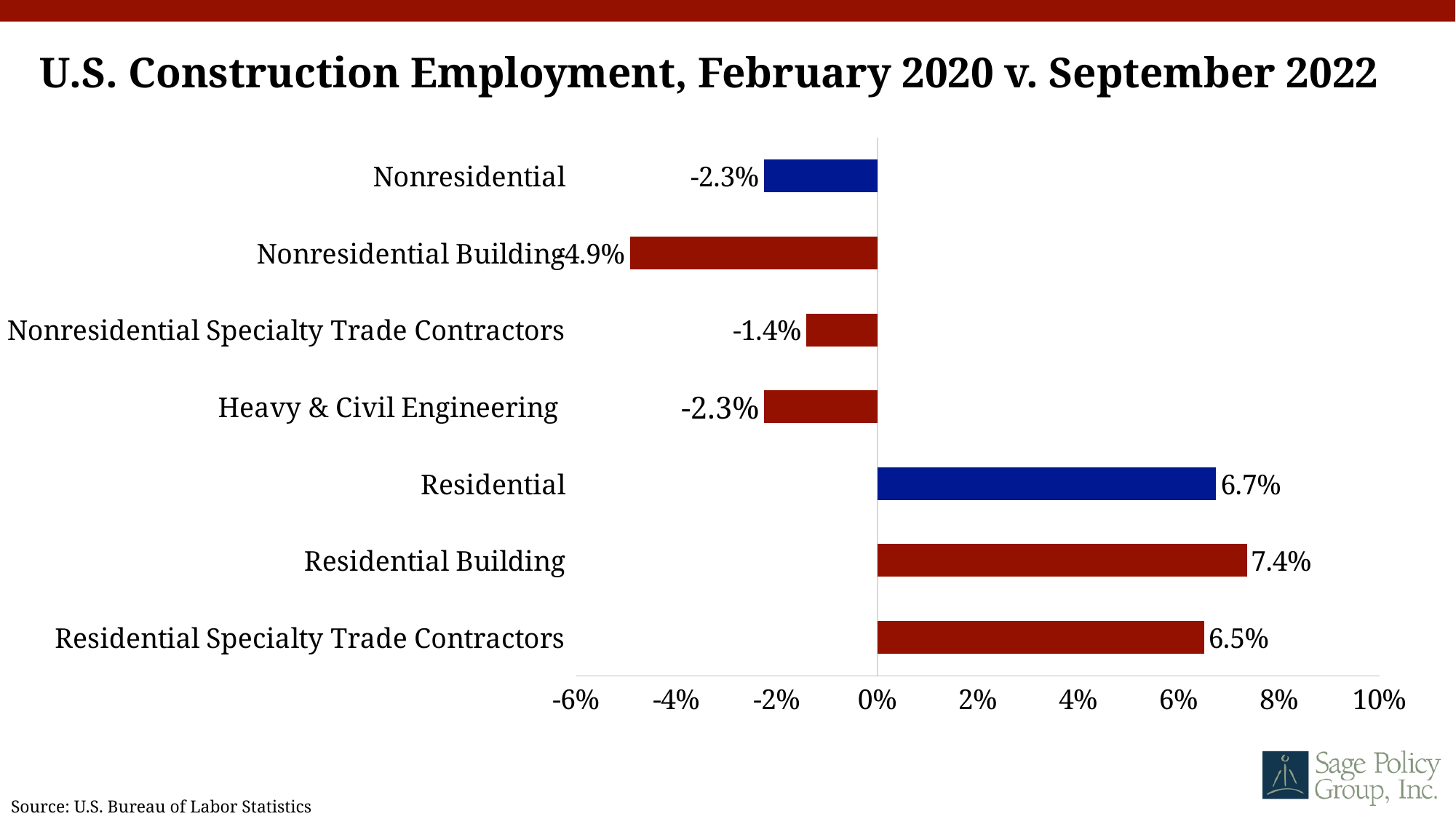
How many categories are shown in the chart? 7 What is the value for Residential Specialty Trade Contractors? 6.5% What kind of chart is shown on the slide? Bar chart Which is larger, the value for Residential or the value for Residential Specialty Trade Contractors? Residential Is the value for Nonresidential Building greater or less than -4%? less What is the value for Heavy & Civil Engineering? -2.3% What is the value for Residential Building? 7.4% What is the difference between the values for Residential Building and Residential Specialty Trade Contractors? 0.9% What is the value for Nonresidential Specialty Trade Contractors? -1.4% Which category has the highest value? Residential Building Which category has the lowest value? Nonresidential Building What is the value for Residential? 6.7%